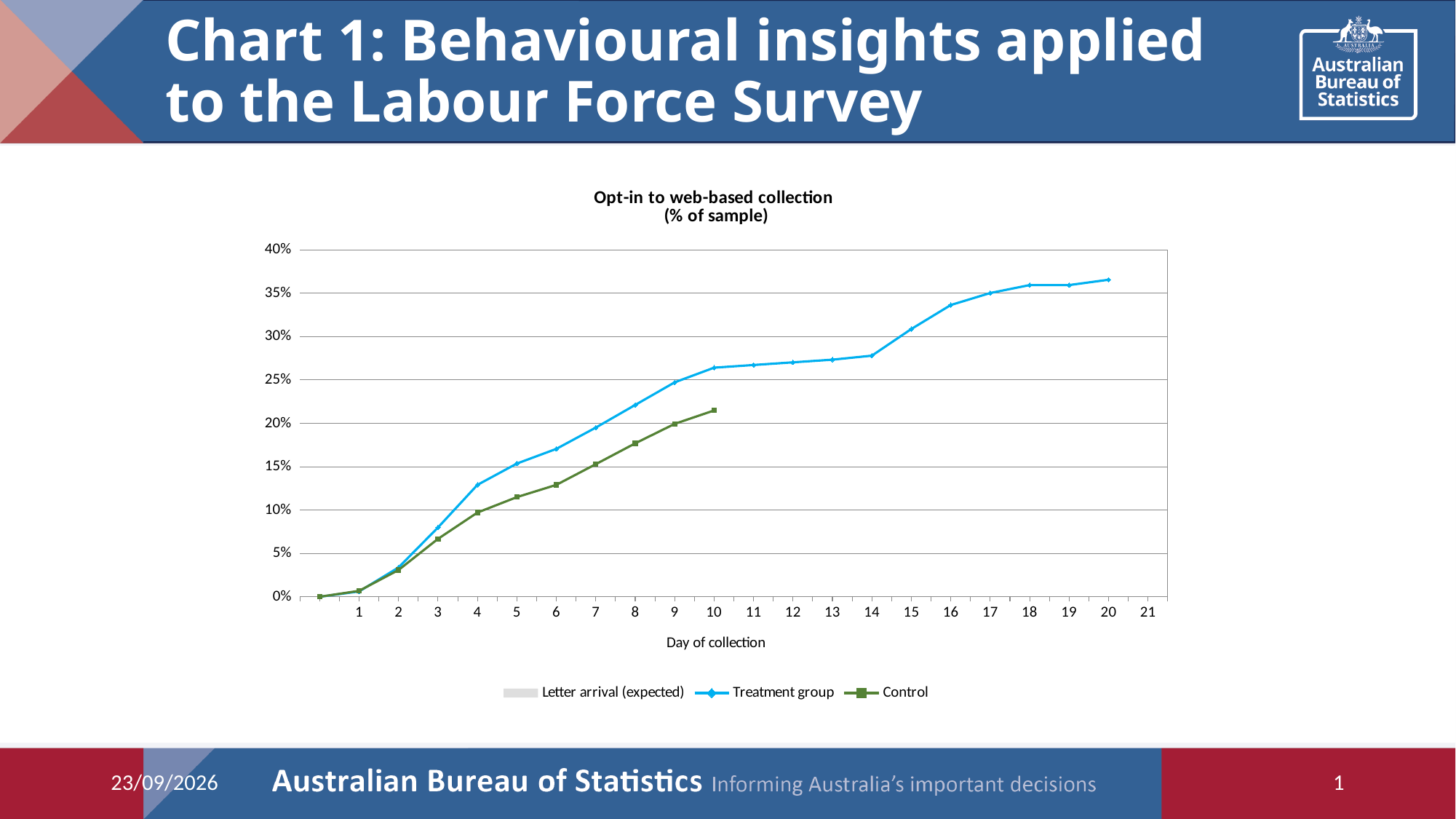
Is the value for the Treatment group on day 20 greater or less than 35%? greater What is the label of the x axis? Day of collection Is the value for the Treatment group on day 16 greater or less than 30%? greater On day 10, which series has the higher value, Treatment group or Control? Treatment group What kind of chart is shown on the slide? line chart Is the value for the Control group on day 6 greater or less than 15%? less How many series does the legend list? 3 Do the values for the Treatment group rise or fall as the day of collection increases? rise What is the title of the chart? Opt-in to web-based collection (% of sample)